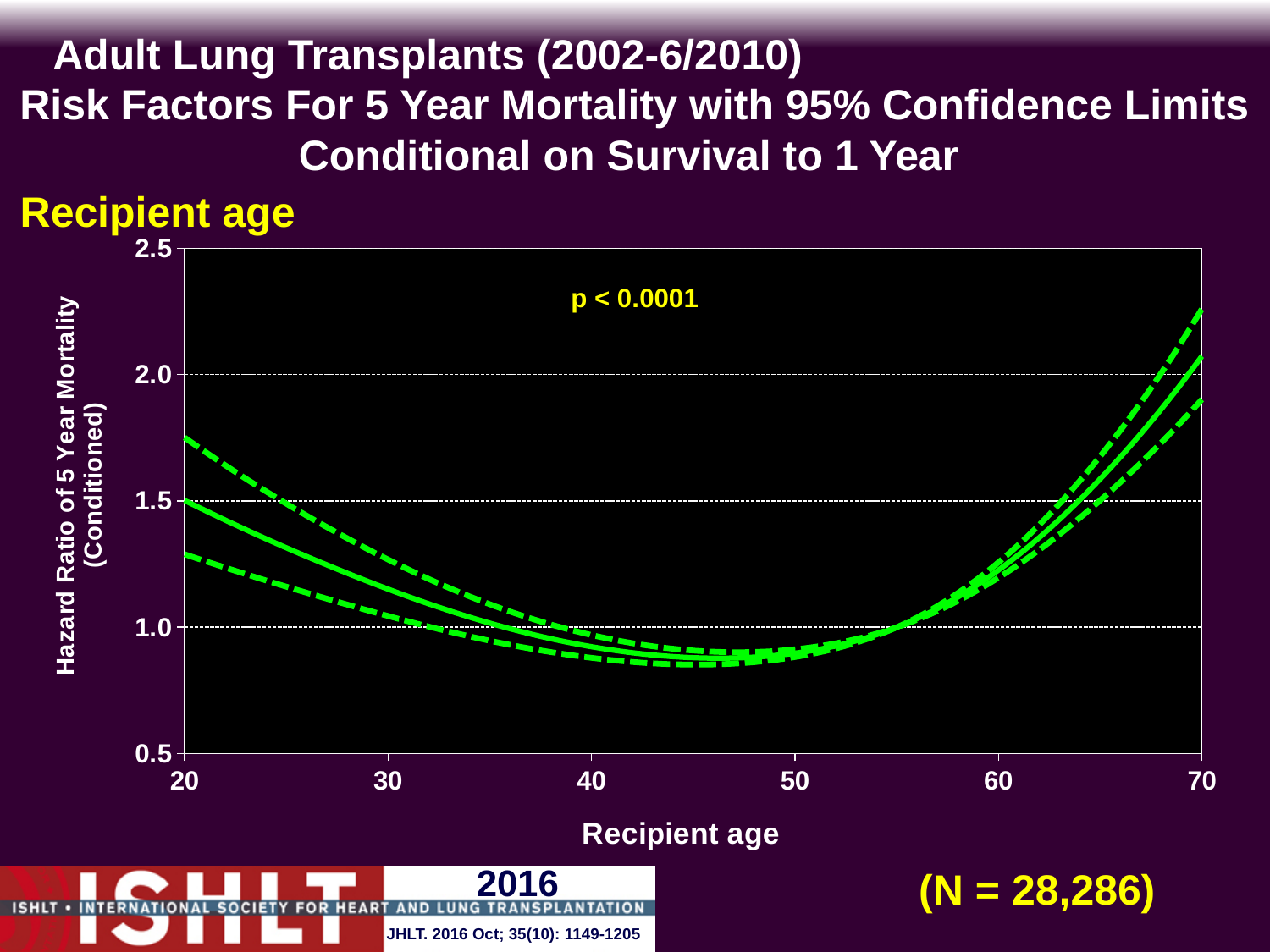
Is the lower confidence limit (lower dashed line) at recipient age 70 greater or less than 2.0? less Is the hazard ratio (solid line) at recipient age 45 greater or less than 1.0? less Which is larger, the hazard ratio at recipient age 70 or at recipient age 20? age 70 Is the hazard ratio (solid line) at recipient age 30 greater or less than 1.0? greater Does the hazard ratio rise or fall as recipient age increases from 55 to 70? rise What kind of chart is shown on the slide? line chart What is the p-value printed on the chart? p < 0.0001 What is the sample size (N) shown on the slide? N = 28,286 Does the hazard ratio rise or fall as recipient age increases from 20 to 45? fall